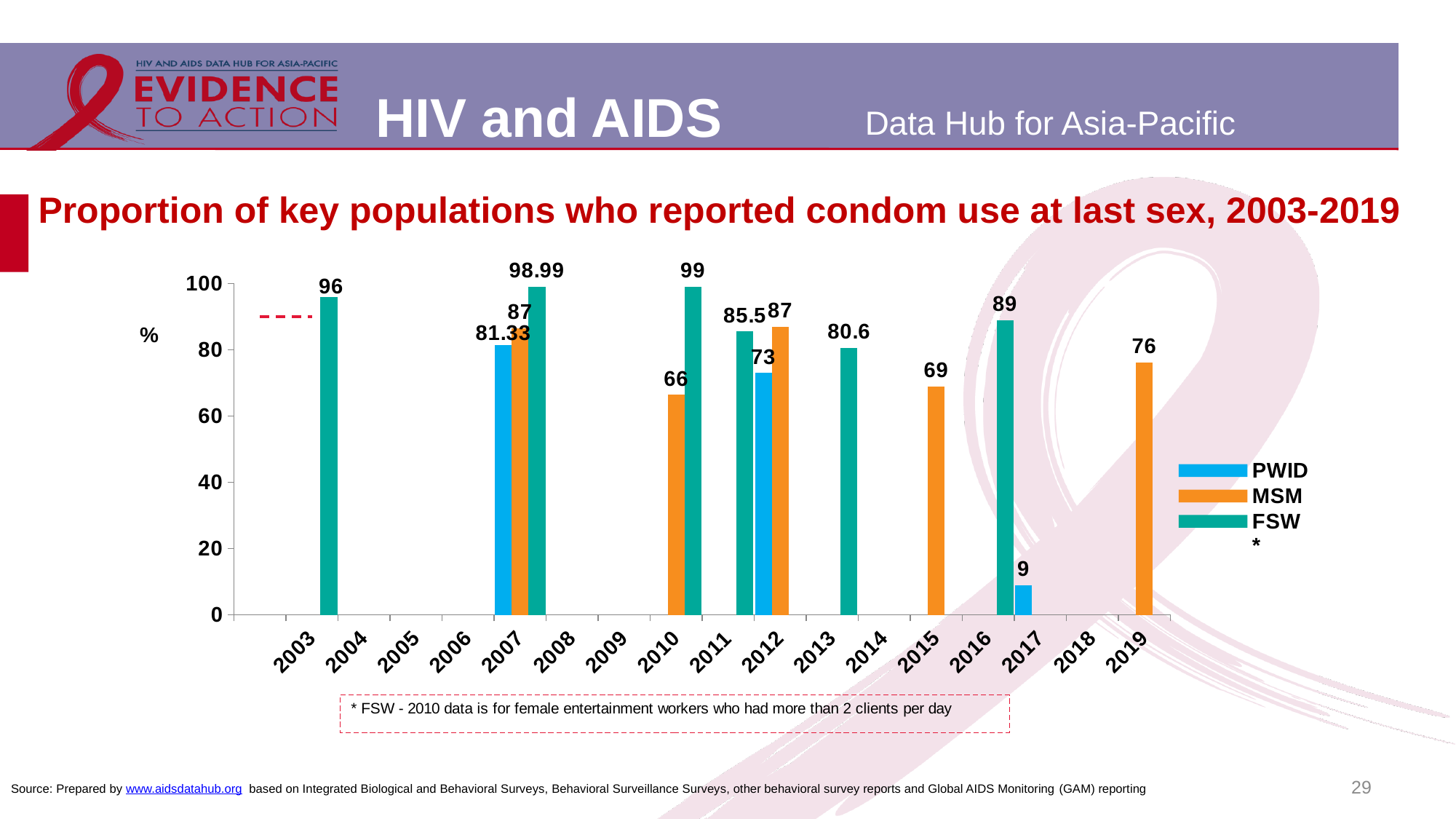
What is the value for FSW in 2007? 98.99 What is the value for FSW in 2003? 96 In which year is the PWID value lowest? 2017 Which is larger, the PWID value in 2007 or the PWID value in 2012? 2007 What is the value for MSM in 2010? 66 How many years are shown on the x axis? 17 What kind of chart is shown on the slide? bar chart What is the difference between the MSM value in 2007 and the MSM value in 2010? 21 What is the difference between the FSW value in 2016 and the FSW value in 2013? 8.4 What is the value for PWID in 2017? 9 How many series does the legend list? 3 What is the value for MSM in 2019? 76